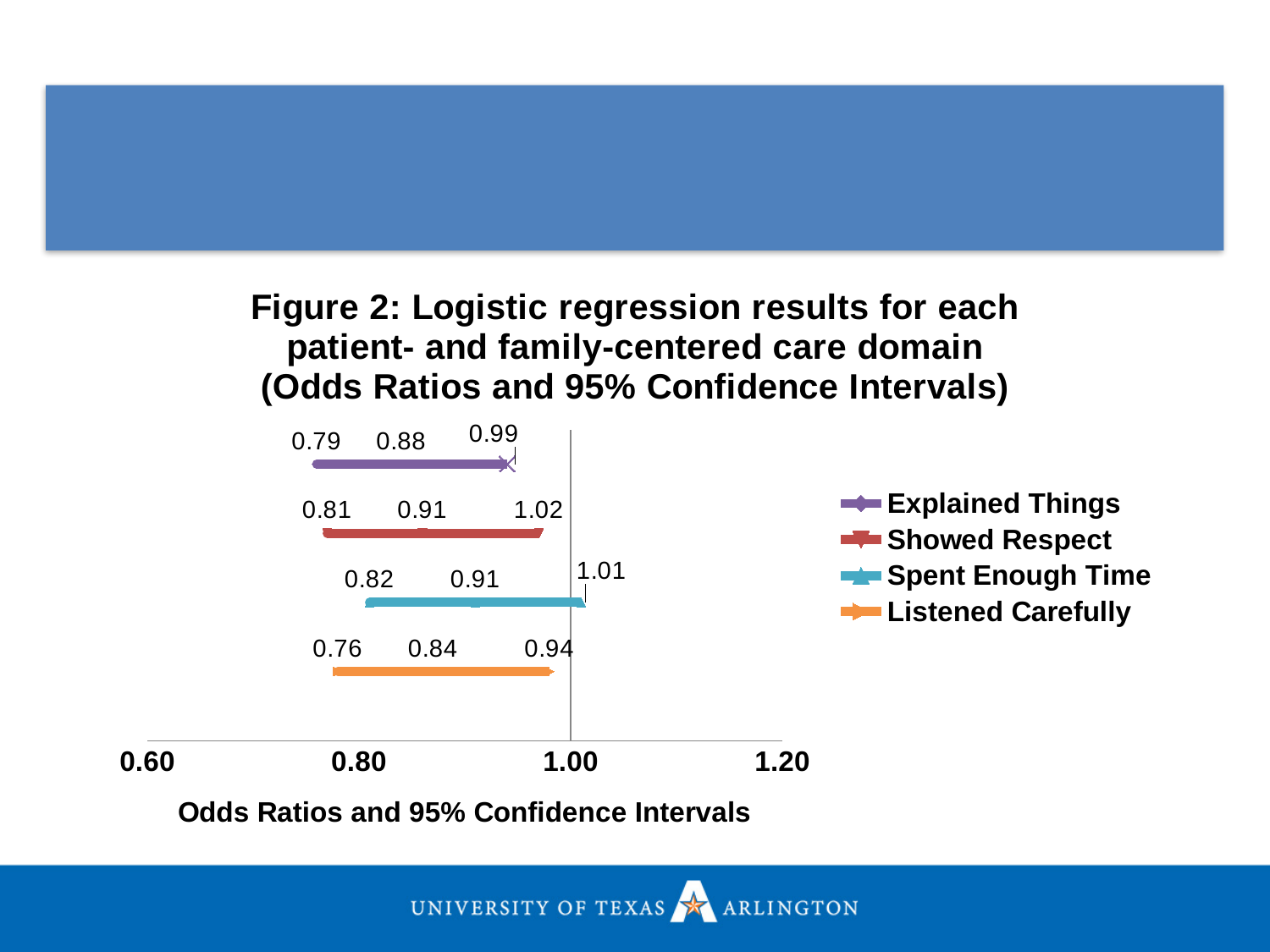
What is the difference between the upper and lower confidence limits for Explained Things? 0.20 Which has the larger odds ratio, Explained Things or Listened Carefully? Explained Things What is the lower confidence limit shown for Explained Things? 0.79 What is the title of the horizontal axis? Odds Ratios and 95% Confidence Intervals What colour represents Listened Carefully in the legend? Orange Which domain has the highest upper confidence limit? Showed Respect What is the odds ratio (middle value) shown for Listened Carefully? 0.84 Is the upper confidence limit for Listened Carefully greater or less than 1.00? less What is the upper confidence limit shown for Showed Respect? 1.02 How many series does the legend list? 4 Which domain has the lowest odds ratio (middle value)? Listened Carefully What is the odds ratio (middle value) shown for Spent Enough Time? 0.91